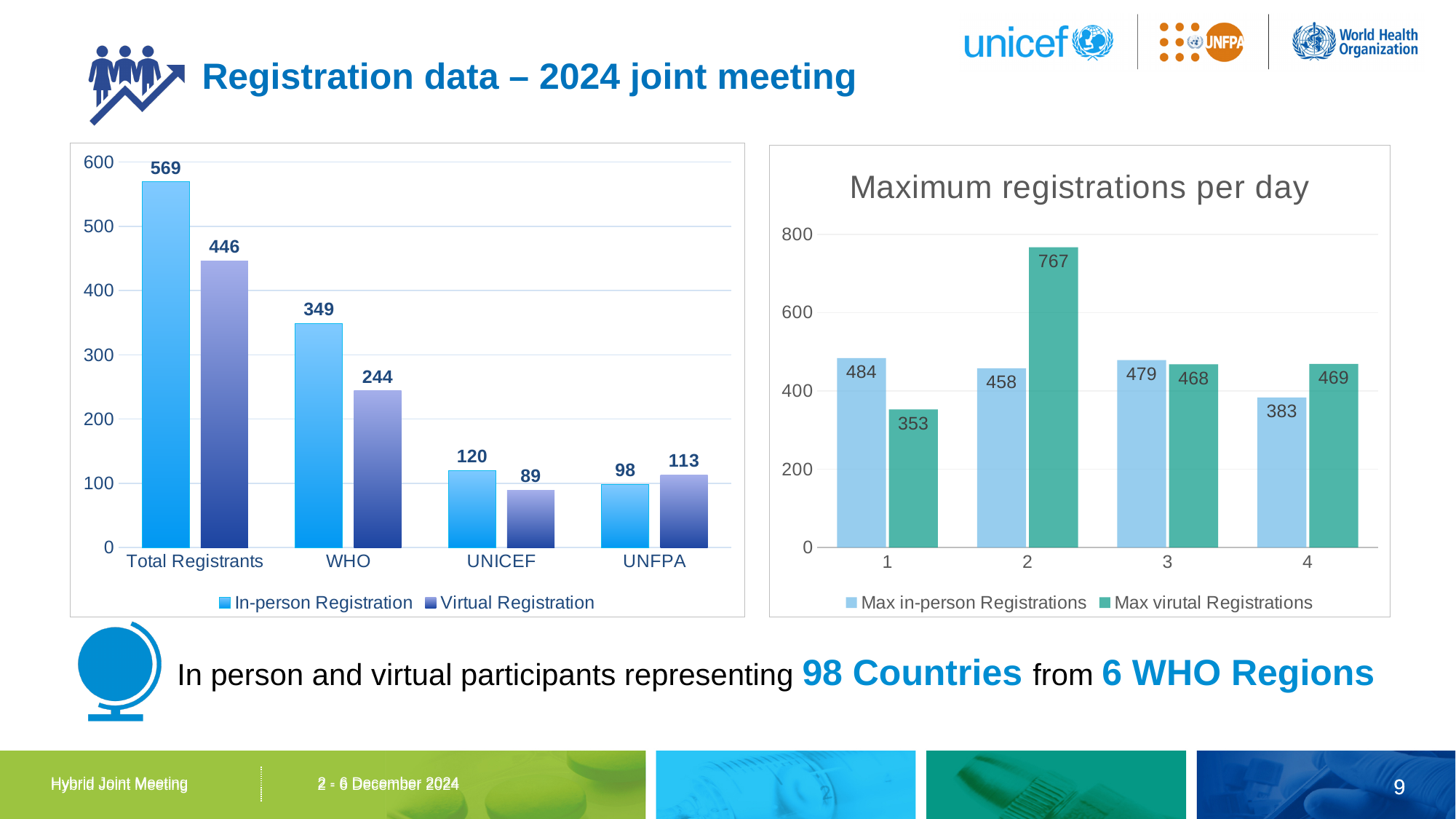
In the 'Maximum registrations per day' chart, what is the Max virtual Registrations value for day 2? 767 In the left chart, how many categories are shown on the x axis? 4 In the 'Maximum registrations per day' chart, which day has the highest Max in-person Registrations value? 1 In the left chart, what is the Virtual Registration value for UNFPA? 113 In the 'Maximum registrations per day' chart, what is the difference between Max virtual Registrations and Max in-person Registrations on day 4? 86 What kind of chart is the 'Maximum registrations per day' chart? Bar chart In the left chart, which is larger for UNICEF: In-person Registration or Virtual Registration? In-person Registration In the left chart, which category has the lowest In-person Registration value? UNFPA In the left chart, what is the In-person Registration value for WHO? 349 In the 'Maximum registrations per day' chart, how many series does the legend list? 2 In the 'Maximum registrations per day' chart, is the Max in-person Registrations value for day 3 greater or less than 400? greater In the left chart, what is the difference between In-person Registration and Virtual Registration for Total Registrants? 123